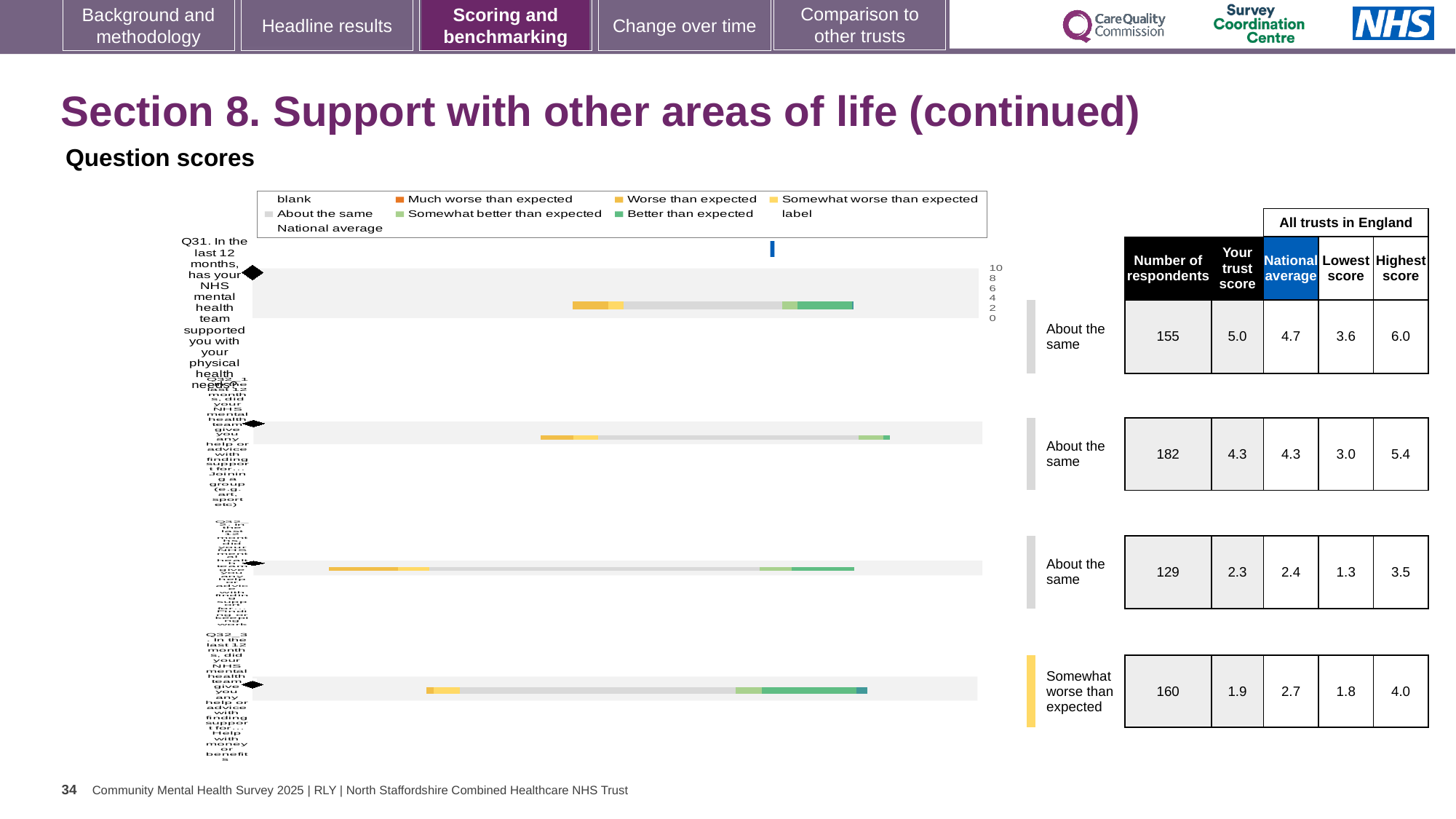
In the table beside the chart, what is the difference between the 'National average' and 'Your trust score' for the row with 160 respondents? 0.8 Which benchmark category is shown next to the bottom bar of the chart? Somewhat worse than expected In the table beside the chart, what is the 'National average' for the row with 182 respondents? 4.3 In the table beside the chart, what is the 'Your trust score' for the first row (155 respondents)? 5.0 How many question bars are plotted in the chart? 4 In the table beside the chart, what is the 'Highest score' for the row with 129 respondents? 3.5 Which colour represents 'Better than expected' in the chart legend? green In the table beside the chart, which row has the lowest 'Your trust score'? the row with 160 respondents (1.9) Which question label appears at the top of the chart? Q31 How many entries does the chart legend list? 9 What is the highest tick value shown on the chart's axis? 10 What kind of chart is shown under 'Question scores'? bar chart